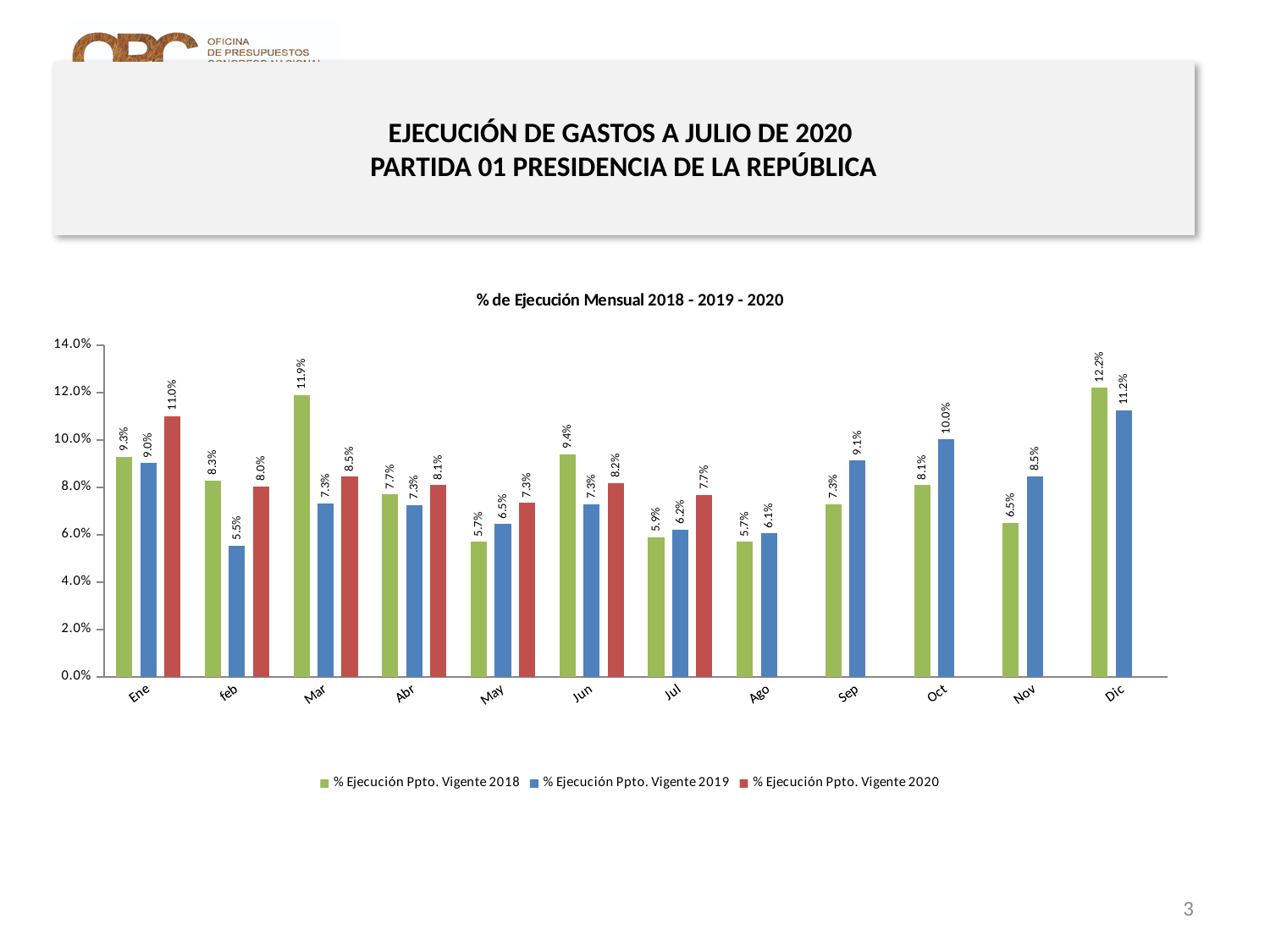
What is the value of % Ejecución Ppto. Vigente 2020 for Ene? 11.0% For Jul, which is larger: the 2018 value or the 2020 value? 2020 value How many series does the legend list? 3 What is the value of % Ejecución Ppto. Vigente 2018 for Mar? 11.9% How many months are shown on the x axis? 12 What is the difference between the 2020 and 2019 values for Ene? 2.0% What is the title of the chart? % de Ejecución Mensual 2018 - 2019 - 2020 What kind of chart is shown on the slide? Bar chart Which month has the highest value for % Ejecución Ppto. Vigente 2018? Dic Which month has the lowest value for % Ejecución Ppto. Vigente 2019? feb What is the value of % Ejecución Ppto. Vigente 2019 for Oct? 10.0% Is the value for % Ejecución Ppto. Vigente 2019 in Dic greater or less than 10.0%? greater